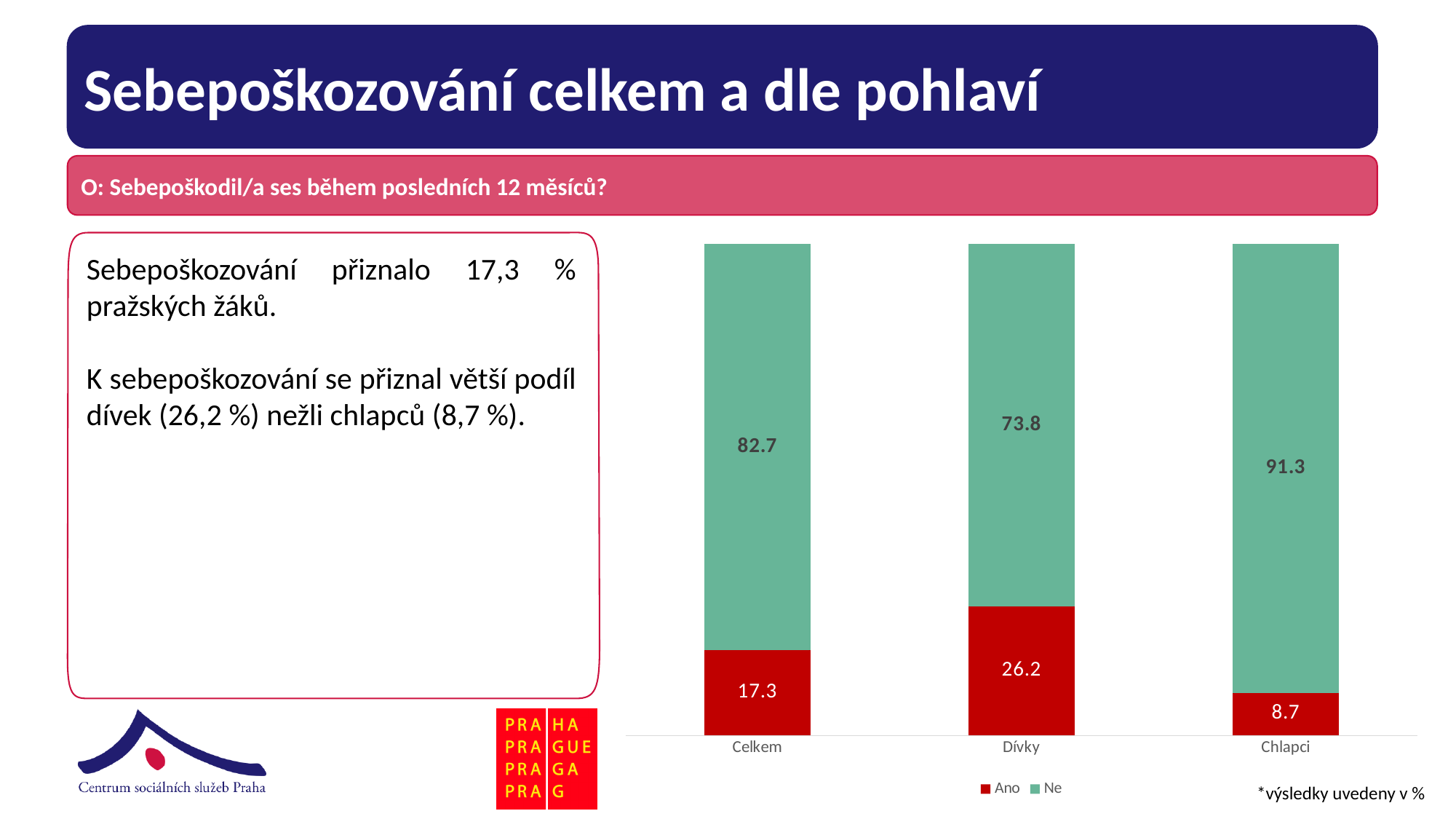
What is the total of the stacked bar for Celkem? 100 How many series does the legend list? 2 What is the value of the Ne series for Chlapci? 91.3 How many categories are shown on the x axis? 3 Which colour represents the Ano series in the legend? Red Which is larger, the Ne value for Celkem or the Ne value for Chlapci? Chlapci Which category has the lowest Ne value? Dívky What is the value of the Ano series for Celkem? 17.3 What is the difference between the Ano values for Dívky and Chlapci? 17.5 Which category has the highest Ano value? Dívky What is the value of the Ano series for Dívky? 26.2 What kind of chart is shown on the slide? Stacked bar chart